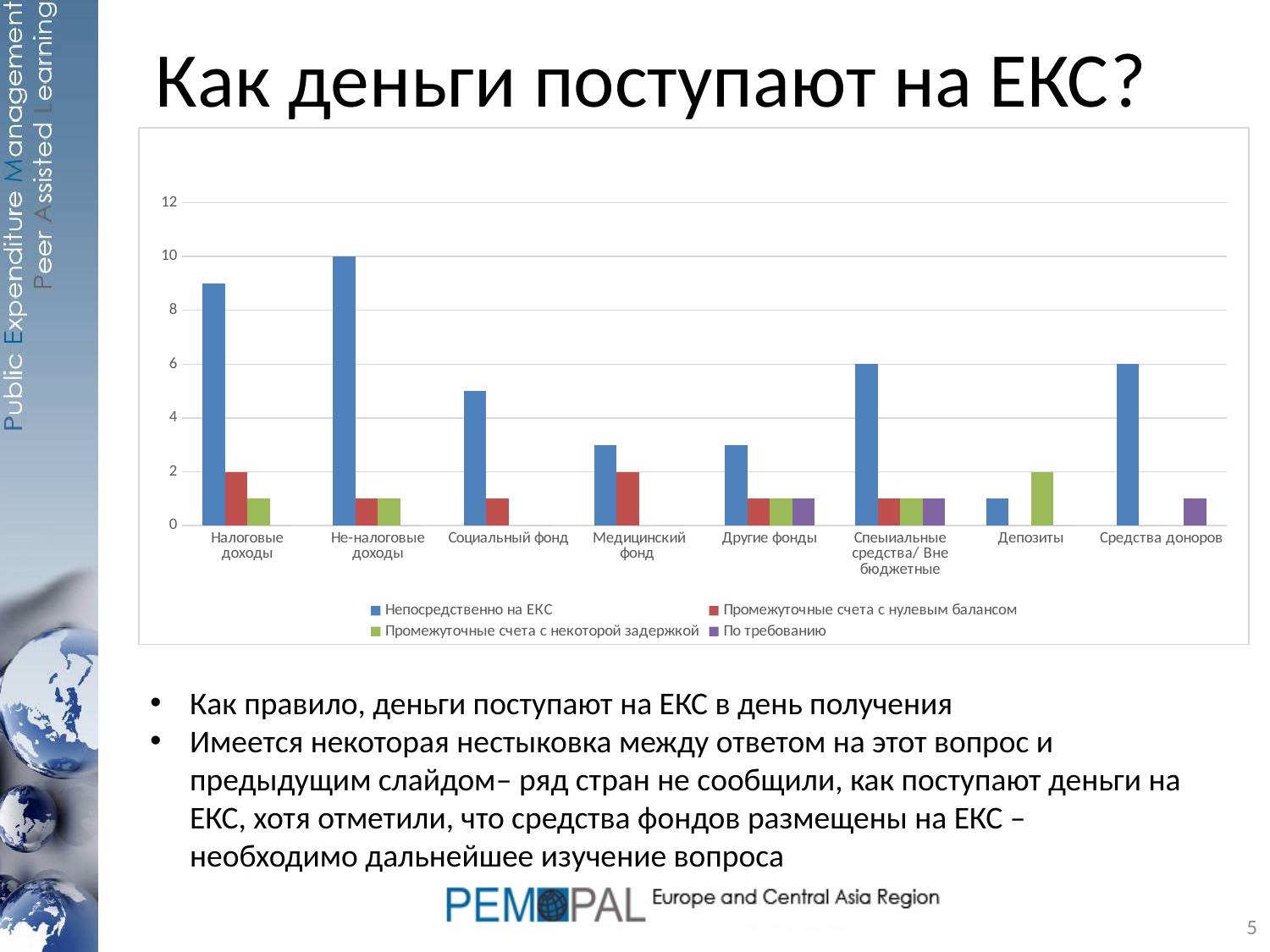
Which is larger for 'Непосредственно на ЕКС': 'Медицинский фонд' or 'Спеыиальные средства/ Вне бюджетные'? Спеыиальные средства/ Вне бюджетные How many categories are shown on the x axis of the chart? 8 What is the value of 'Непосредственно на ЕКС' for 'Средства доноров'? 6 What is the value of 'Промежуточные счета с нулевым балансом' for 'Медицинский фонд'? 2 What is the value of 'Промежуточные счета с некоторой задержкой' for 'Депозиты'? 2 Is the value of 'Непосредственно на ЕКС' for 'Налоговые доходы' greater or less than 8? greater What kind of chart is shown on the slide? bar chart Which category has the highest value for 'Непосредственно на ЕКС'? Не-налоговые доходы Is the value of 'Непосредственно на ЕКС' for 'Социальный фонд' greater or less than 4? greater Which series is shown in blue in the chart legend? Непосредственно на ЕКС What is the value of 'Непосредственно на ЕКС' for 'Не-налоговые доходы'? 10 How many series does the chart legend list? 4